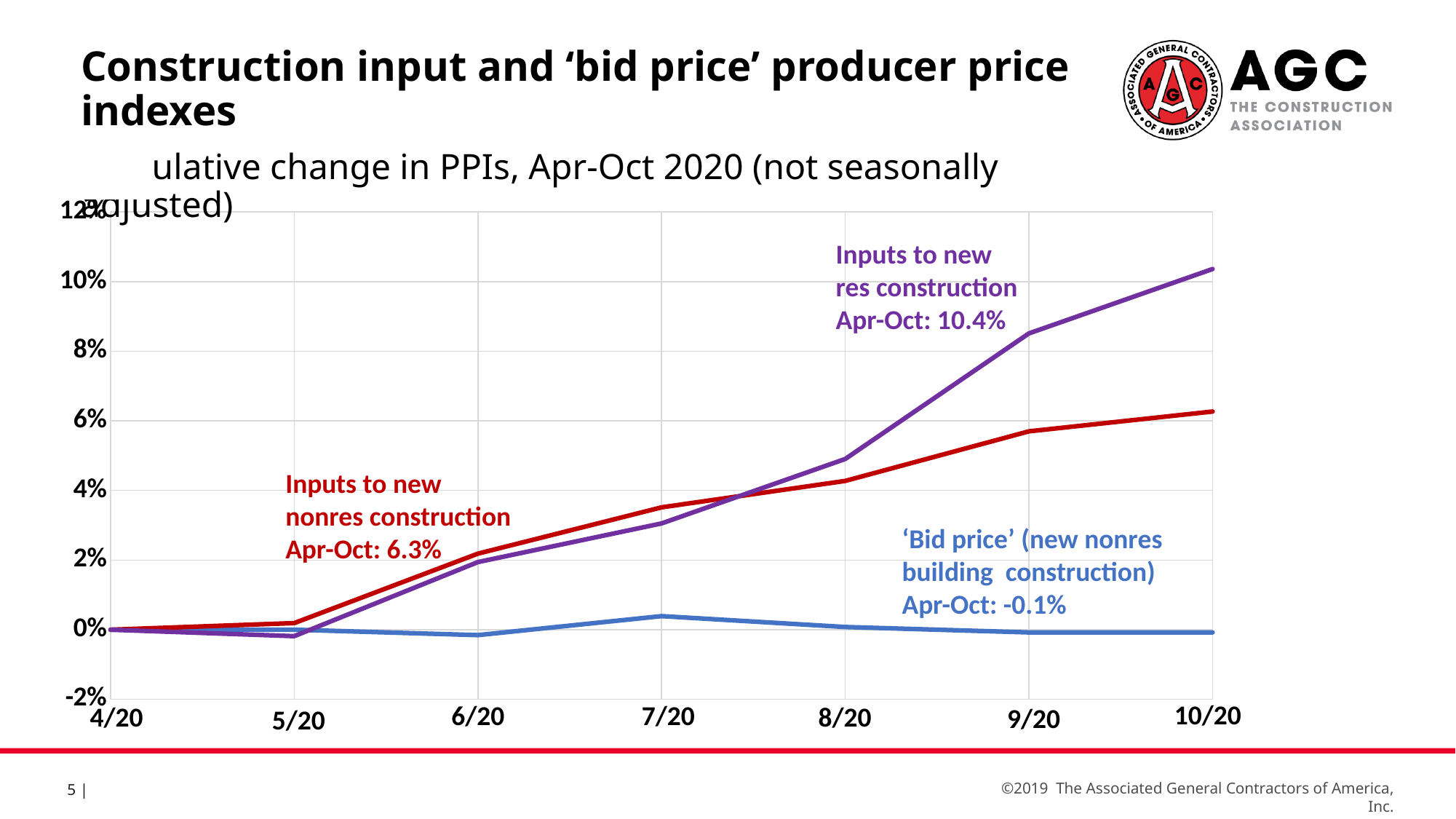
How many lines are plotted on the chart? 3 Which series shows the largest Apr-Oct cumulative change? Inputs to new res construction Is the value for inputs to new nonres construction at 9/20 greater or less than 6%? less Does the inputs to new res construction line rise or fall from 5/20 to 10/20? rise What is the Apr-Oct cumulative change for inputs to new res construction? 10.4% Which series shows the smallest Apr-Oct cumulative change? 'Bid price' (new nonres building construction) What kind of chart is shown on the slide? line chart What is the Apr-Oct cumulative change for inputs to new nonres construction? 6.3% How many months are shown along the x axis? 7 What is the Apr-Oct cumulative change for the 'bid price' (new nonres building construction) series? -0.1% How many percentage points higher is the Apr-Oct change for inputs to new res construction than for inputs to new nonres construction? 4.1 percentage points Is the value for inputs to new res construction at 9/20 greater or less than 8%? greater